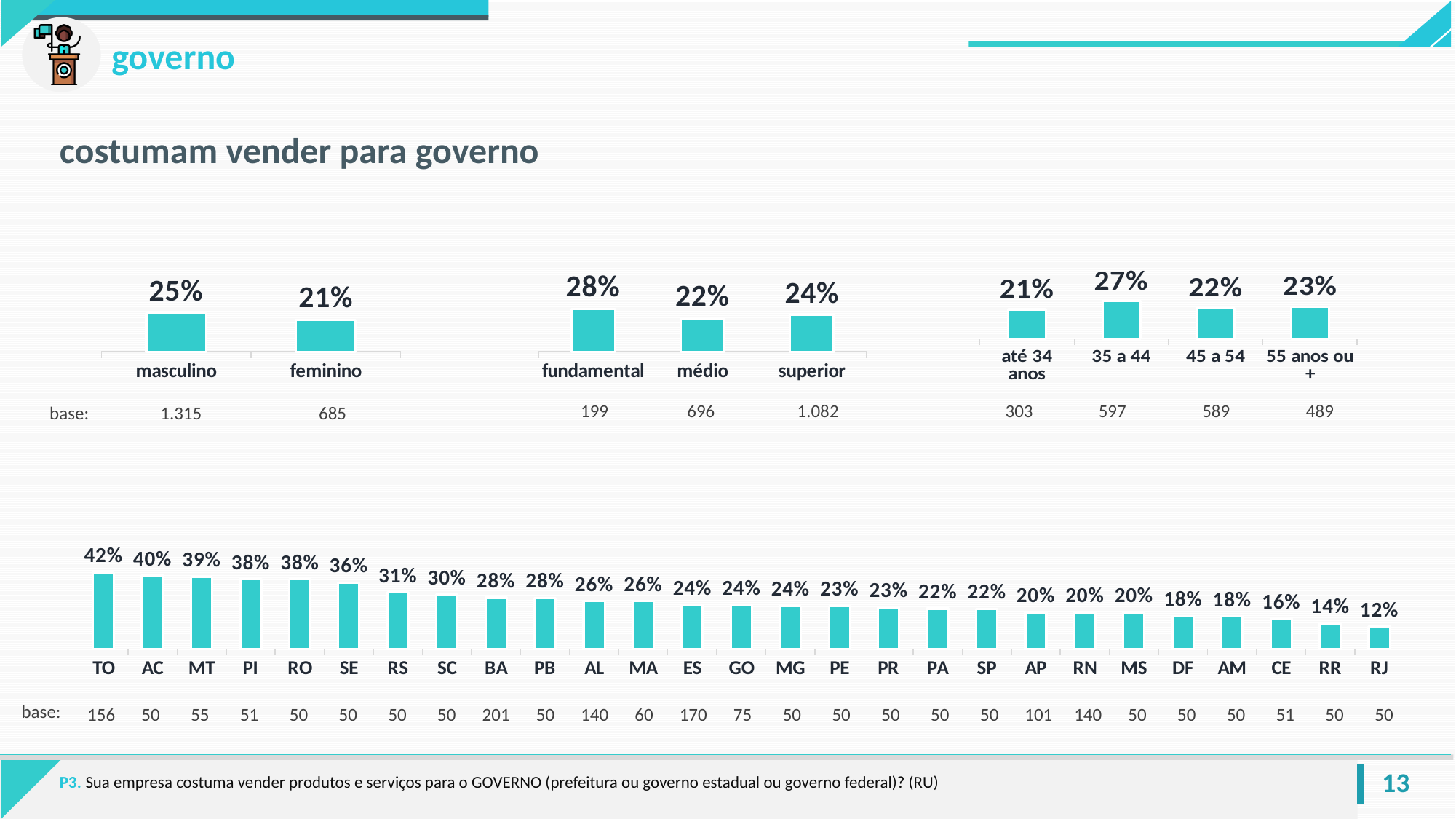
In the education chart at the top centre, which category has the highest value? fundamental In the age-group chart at the top right, what is the value for 45 a 54? 22% In the state chart at the bottom, what is the value for SP? 22% In the education chart at the top centre, what is the value for superior? 24% In the state chart at the bottom, which state has the lowest value? RJ In the gender chart at the top left, what is the difference between masculino and feminino? 4% In the age-group chart at the top right, how many age categories are shown? 4 In the state chart at the bottom, which is larger, the value for RS or the value for BA? RS In the state chart at the bottom, which state has the highest value? TO In the state chart at the bottom, how many states are shown? 27 In the age-group chart at the top right, which category has the highest value? 35 a 44 In the gender chart at the top left, what is the value for masculino? 25%